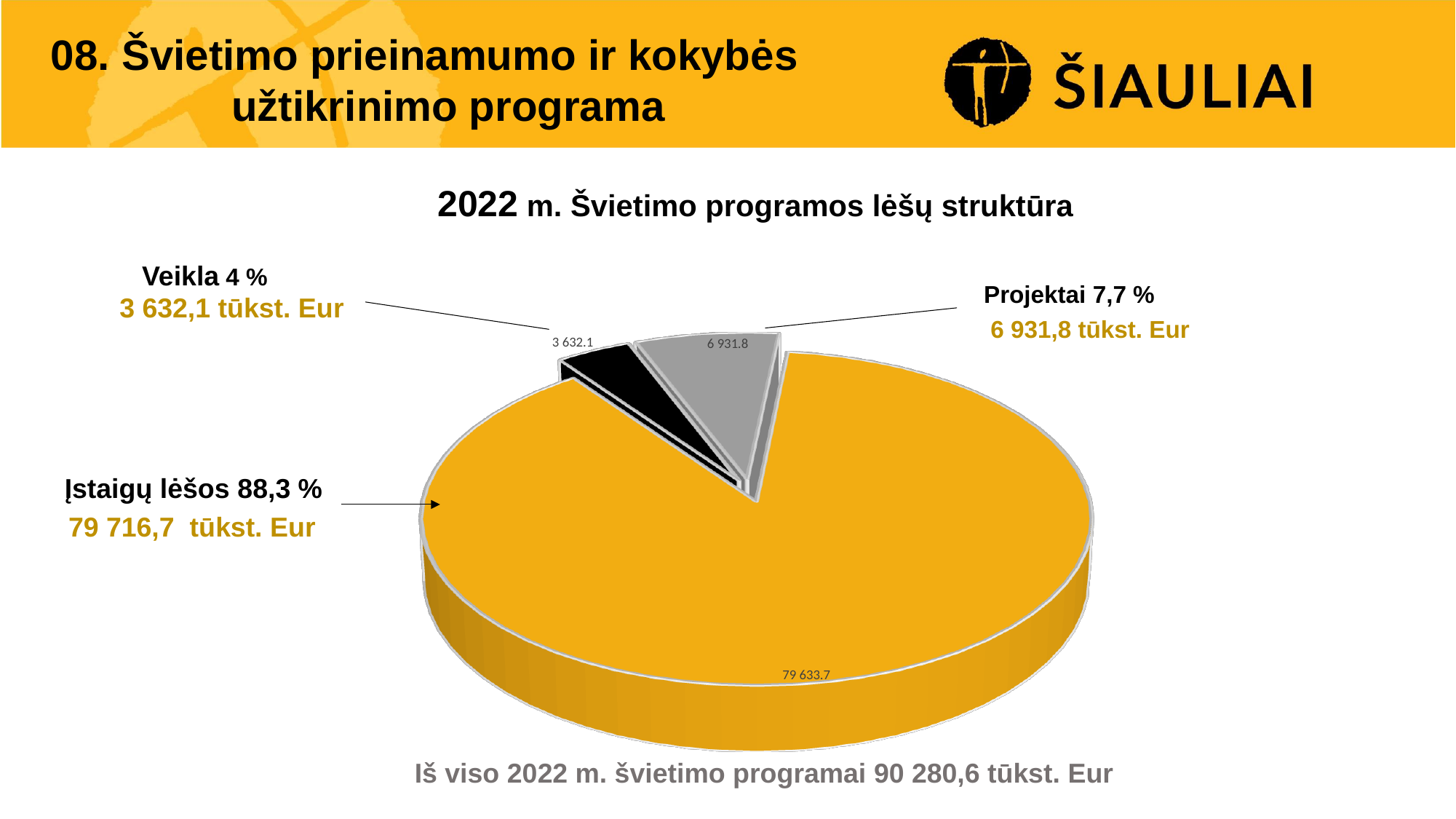
Which is larger, the value for Projektai or the value for Veikla? Projektai What share of the pie does Projektai represent? 7,7 % What is the value for Projektai in tūkst. Eur? 6 931,8 tūkst. Eur What share of the pie does Įstaigų lėšos represent? 88,3 % Which category has the largest slice of the pie? Įstaigų lėšos What is the title of the chart? 2022 m. Švietimo programos lėšų struktūra What kind of chart is shown on the slide? pie chart Which category has the smallest slice of the pie? Veikla What share of the pie does Veikla represent? 4 % What is the difference between the value for Projektai and the value for Veikla, in tūkst. Eur? 3 299,7 tūkst. Eur What is the value for Veikla in tūkst. Eur? 3 632,1 tūkst. Eur How many slices does the pie chart have? 3